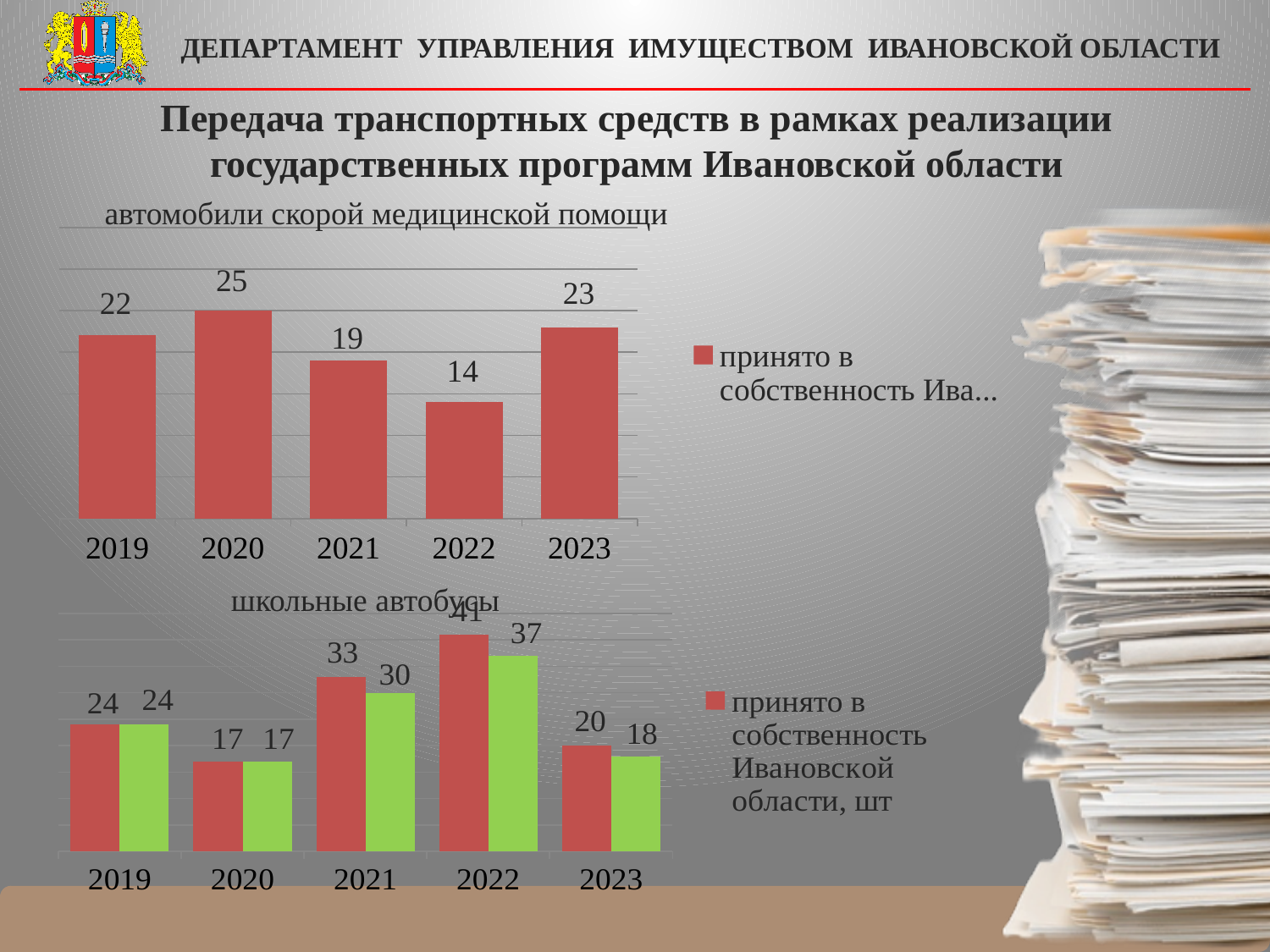
In the chart titled 'автомобили скорой медицинской помощи', what is the difference between the values for 2020 and 2022? 11 In the chart titled 'школьные автобусы', how many bars are shown for each year? 2 In the chart titled 'школьные автобусы', what is the value of the green bar for 2021? 30 What kind of chart is the chart titled 'автомобили скорой медицинской помощи'? bar chart In the chart titled 'школьные автобусы', is the red bar for 2021 larger or smaller than the red bar for 2023? larger In the chart titled 'школьные автобусы', what is the difference between the red and green bars for 2022? 4 In the chart titled 'автомобили скорой медицинской помощи', which year has the lowest value? 2022 In the chart titled 'автомобили скорой медицинской помощи', what is the value for 2020? 25 In the chart titled 'школьные автобусы', which year has the highest red bar? 2022 In the chart titled 'автомобили скорой медицинской помощи', which year has the highest value? 2020 In the chart titled 'школьные автобусы', what is the value of the red bar for 2022? 41 In the chart titled 'автомобили скорой медицинской помощи', how many years are shown on the x axis? 5